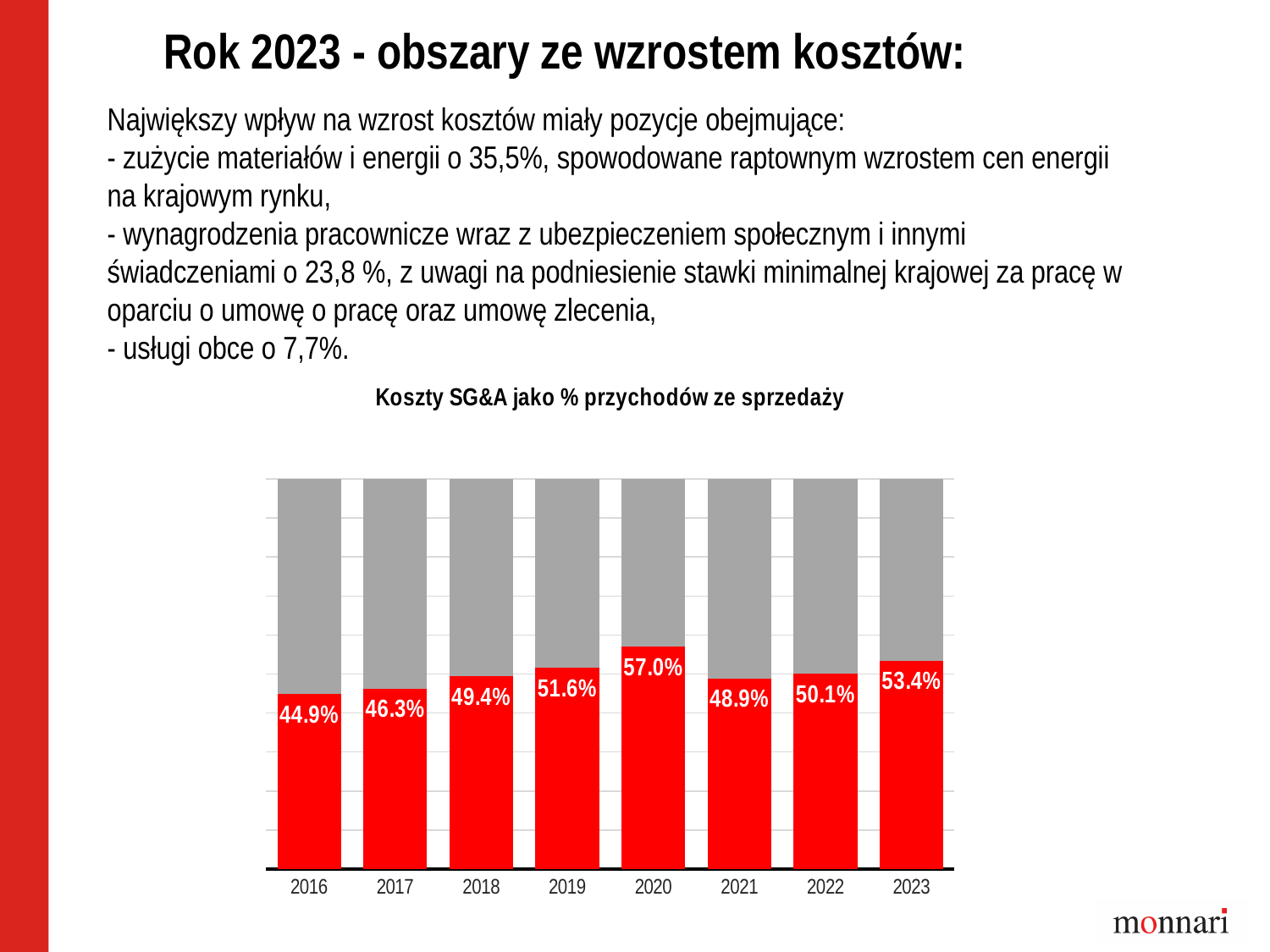
Which year has the highest SG&A cost share of sales revenue? 2020 What type of chart is used on the slide? Bar chart By how many percentage points did the SG&A share change from 2022 to 2023? 3.3 percentage points What is the title of the chart? Koszty SG&A jako % przychodów ze sprzedaży Did the SG&A share of sales revenue rise or fall from 2016 to 2020? Rise What is the value shown for 2016? 44.9% What is the difference between the 2020 value and the 2021 value? 8.1 percentage points Which year has the lowest SG&A cost share of sales revenue? 2016 What is the SG&A cost as a percentage of sales revenue for 2023? 53.4% What value is shown for 2020 in the chart? 57.0% Which year has a higher value, 2019 or 2022? 2019 How many years are shown on the x axis of the chart? 8